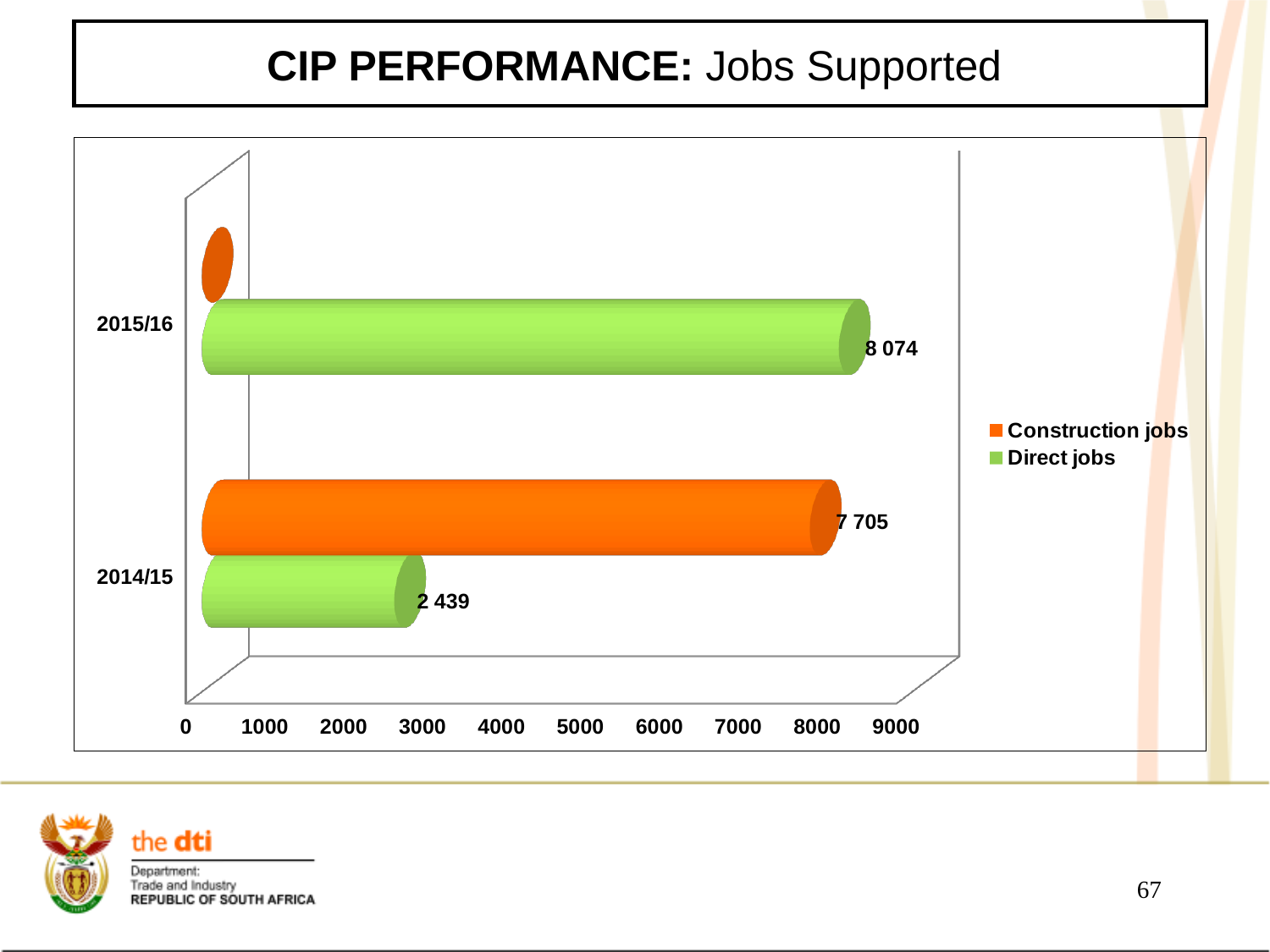
How many categories (years) are shown on the chart? 2 Which colour represents Construction jobs in the legend? Orange Which year has the higher value for Direct jobs? 2015/16 What is the value for Direct jobs in 2015/16? 8 074 Is the value for Construction jobs in 2015/16 greater or less than 1000? less What is the value for Construction jobs in 2014/15? 7 705 What is the difference between Construction jobs and Direct jobs in 2014/15? 5 266 What kind of chart is shown on the slide? Bar chart Which year has the higher value for Construction jobs? 2014/15 What is the value for Direct jobs in 2014/15? 2 439 What is the difference between Direct jobs in 2015/16 and Direct jobs in 2014/15? 5 635 How many series does the legend list? 2